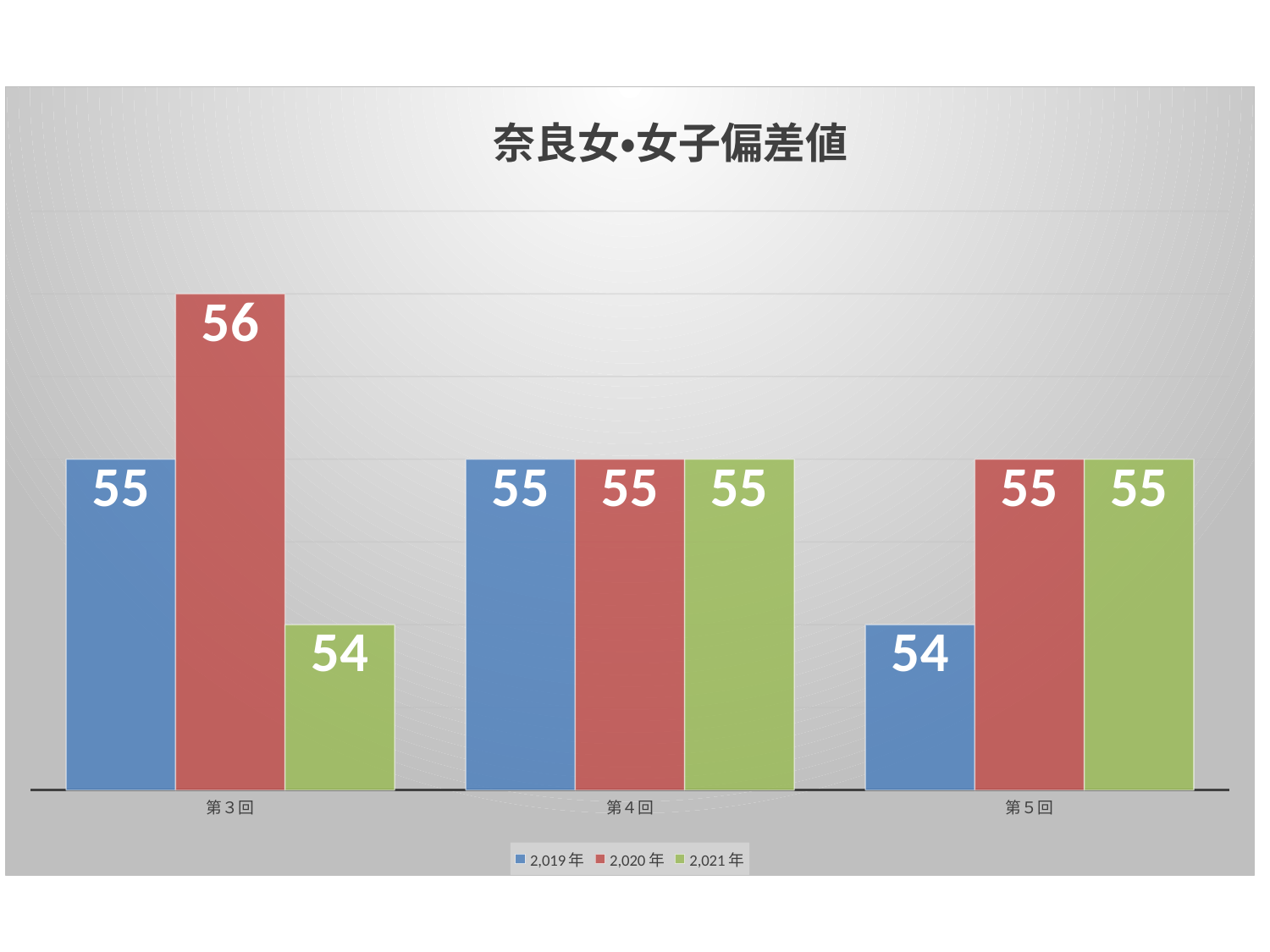
How many categories are shown on the x axis? 3 How many series does the legend list? 3 What is the difference between the 2,020年 and 2,021年 values in 第３回? 2 What is the value for 2,021年 in 第３回? 54 What is the value for 2,020年 in 第３回? 56 Which series has the lowest value in 第５回? 2,019年 What kind of chart is shown? bar chart Which is larger: the 2,019年 value in 第５回 or the 2,020年 value in 第５回? 2,020年 What is the value for 2,021年 in 第４回? 55 What is the value for 2,019年 in 第５回? 54 What is the value for 2,019年 in 第３回? 55 Which series has the highest value in 第３回? 2,020年